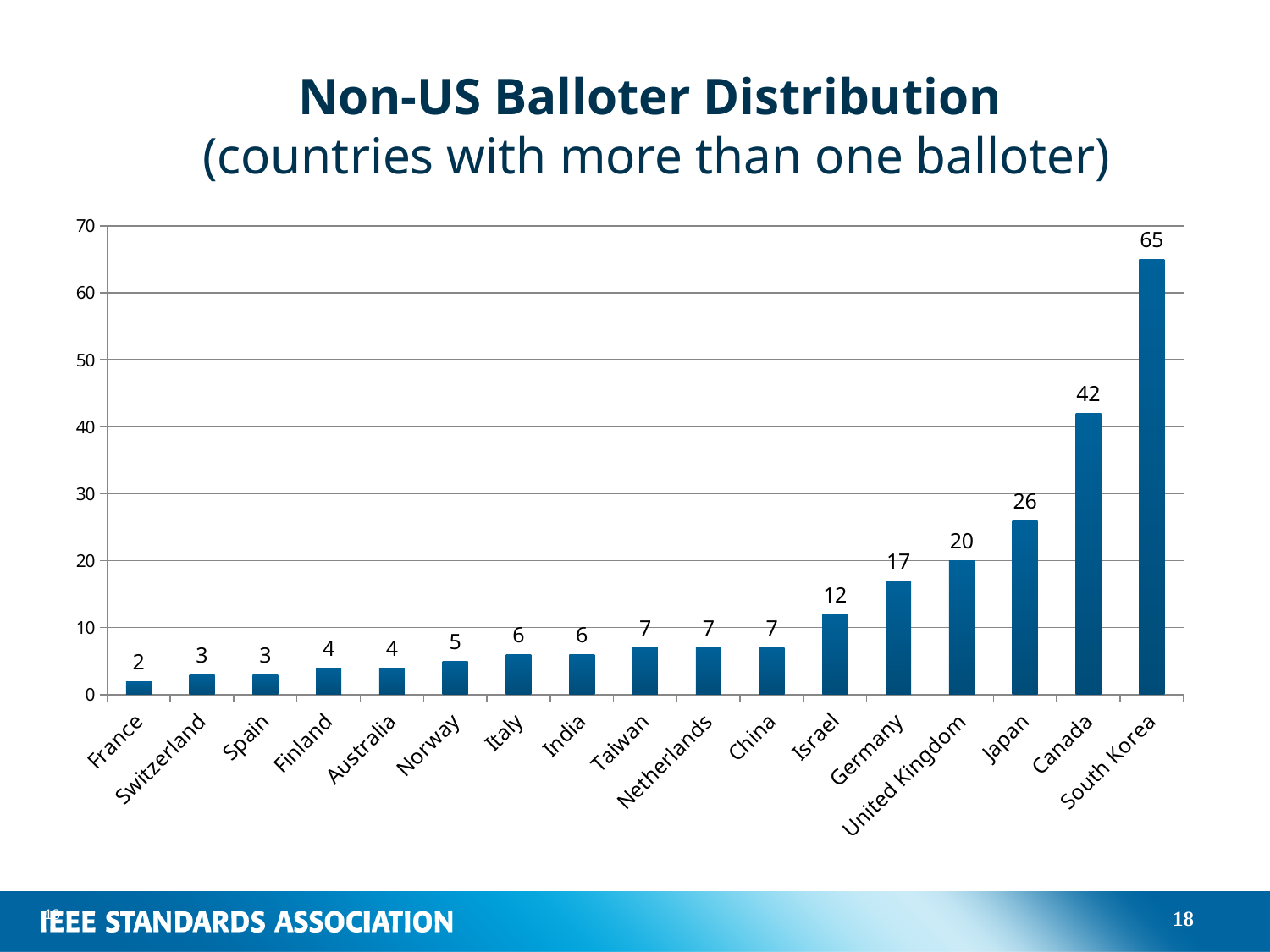
What is the value for Germany? 17 What is the value for South Korea? 65 What is the difference between the values for South Korea and Canada? 23 What is the difference between the values for Japan and United Kingdom? 6 Which country has the highest number of balloters? South Korea Is the value for Canada greater or less than 40? greater Do the values rise or fall from left to right along the x axis? rise How many countries are shown on the chart? 17 Which is larger, the value for Israel or the value for China? Israel What kind of chart is shown on the slide? bar chart What is the value for Norway? 5 Which country has the lowest number of balloters? France